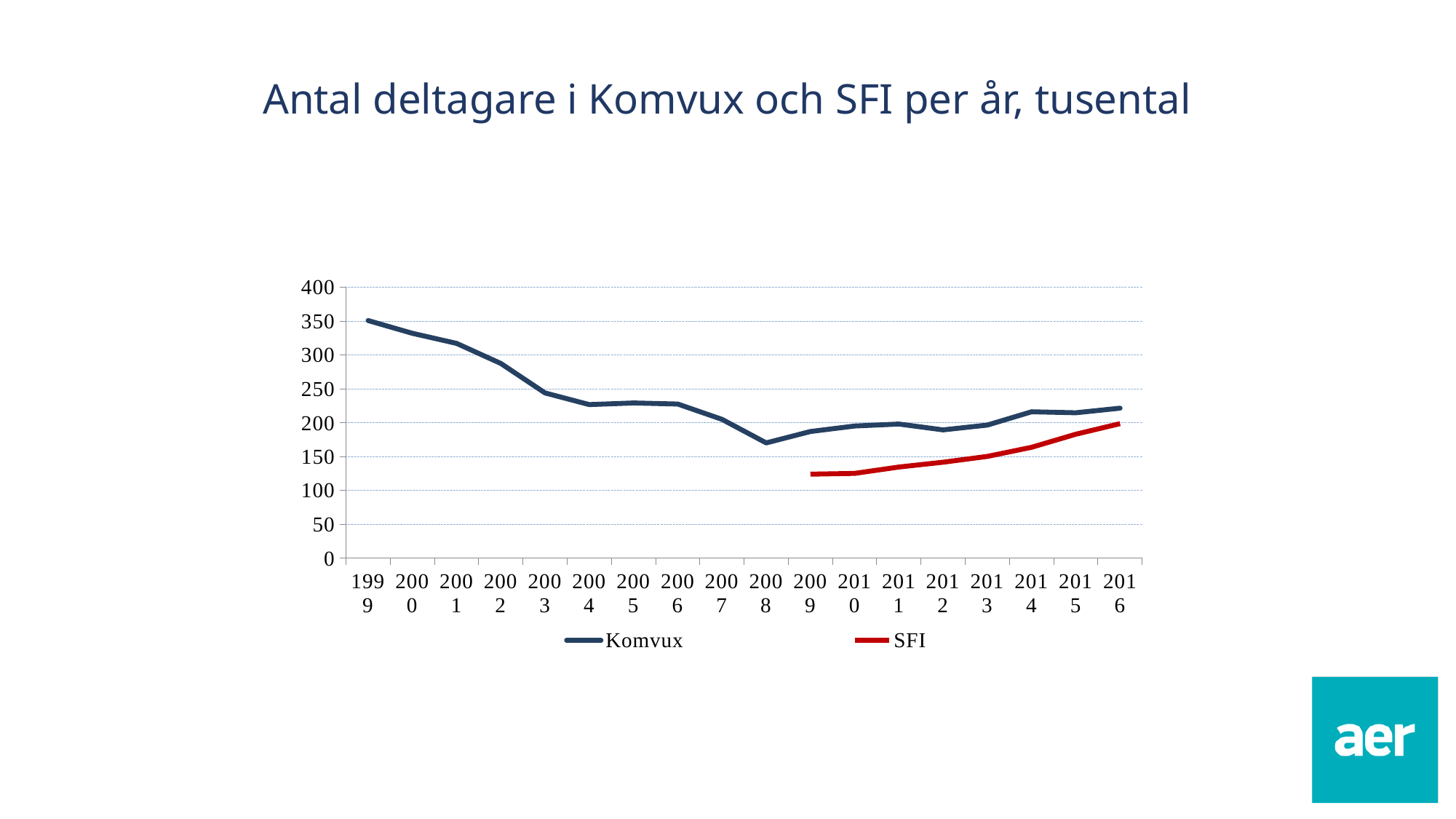
Does the SFI series rise or fall from 2009 to 2016? rise Which series has the larger value in 2010, Komvux or SFI? Komvux Is the SFI value for 2016 greater or less than 150? greater Is the Komvux value for 2008 greater or less than 200? less What is the title of the chart? Antal deltagare i Komvux och SFI per år, tusental Is the SFI value for 2009 greater or less than 150? less What kind of chart is shown on the slide? line chart How many series does the legend list? 2 In which year is the Komvux series at its highest? 1999 How many years are shown on the x axis? 18 In which year is the Komvux series at its lowest? 2008